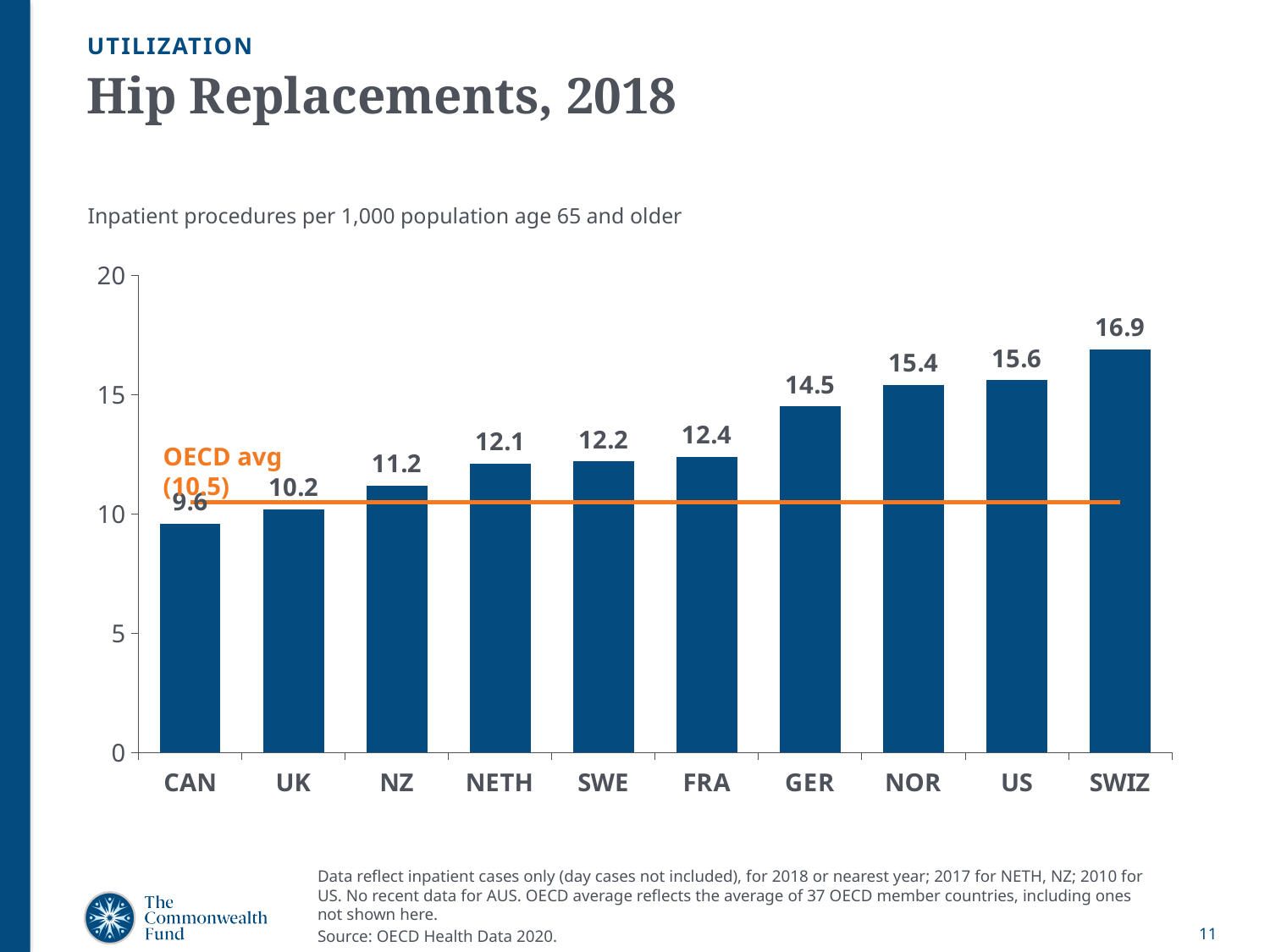
What kind of chart is this? bar chart What is the value for GER? 14.5 Which is larger, the value for NOR or the value for US? US What is the difference between the values for SWIZ and CAN? 7.3 Which country has the highest value? SWIZ Which country has the lowest value? CAN What is the value for CAN? 9.6 Do the values rise or fall from CAN to SWIZ along the x axis? rise How many countries are shown on the chart? 10 Is the value for FRA greater or less than 10? greater What is the title of the chart? Hip Replacements, 2018 What is the OECD average shown on the chart? 10.5